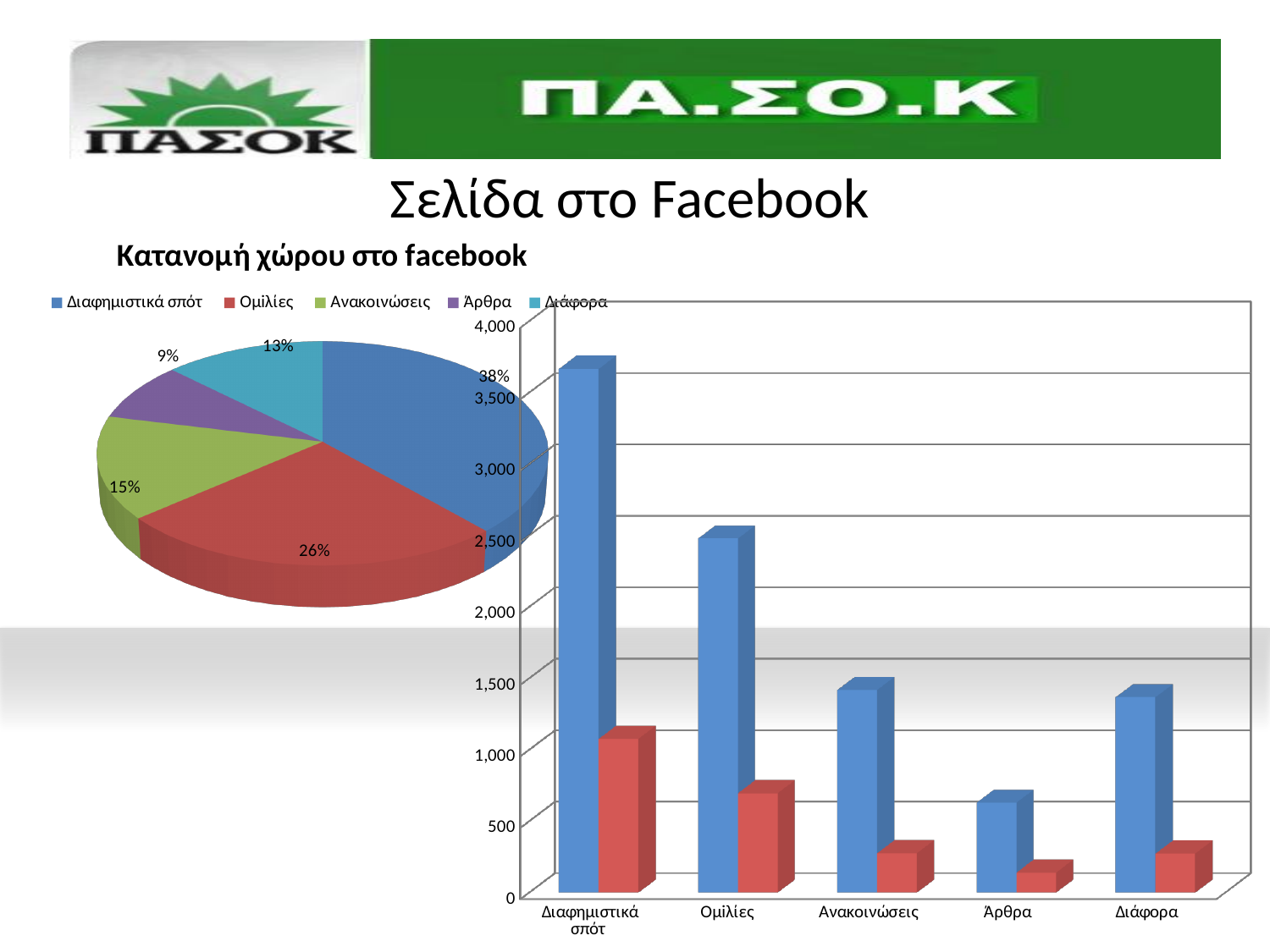
In the pie chart 'Κατανομή χώρου στο facebook', what share does Ομιλίες have? 26% In the pie chart 'Κατανομή χώρου στο facebook', which category has the largest slice? Διαφημιστικά σπότ What kind of chart is the chart on the right of the slide? Bar chart What kind of chart is the chart on the left of the slide? Pie chart In the pie chart 'Κατανομή χώρου στο facebook', how many percentage points larger is the Διαφημιστικά σπότ slice than the Ομιλίες slice? 12 In the pie chart 'Κατανομή χώρου στο facebook', what share does Άρθρα have? 9% In the pie chart 'Κατανομή χώρου στο facebook', what share does Διαφημιστικά σπότ have? 38% In the pie chart 'Κατανομή χώρου στο facebook', how many categories does the legend list? 5 In the bar chart on the right, is the blue bar for Διαφημιστικά σπότ greater or less than 3,000? greater In the bar chart on the right, which category has the lowest blue bar? Άρθρα In the bar chart on the right, is the blue bar for Άρθρα greater or less than 1,000? less In the pie chart 'Κατανομή χώρου στο facebook', which category has the smallest slice? Άρθρα